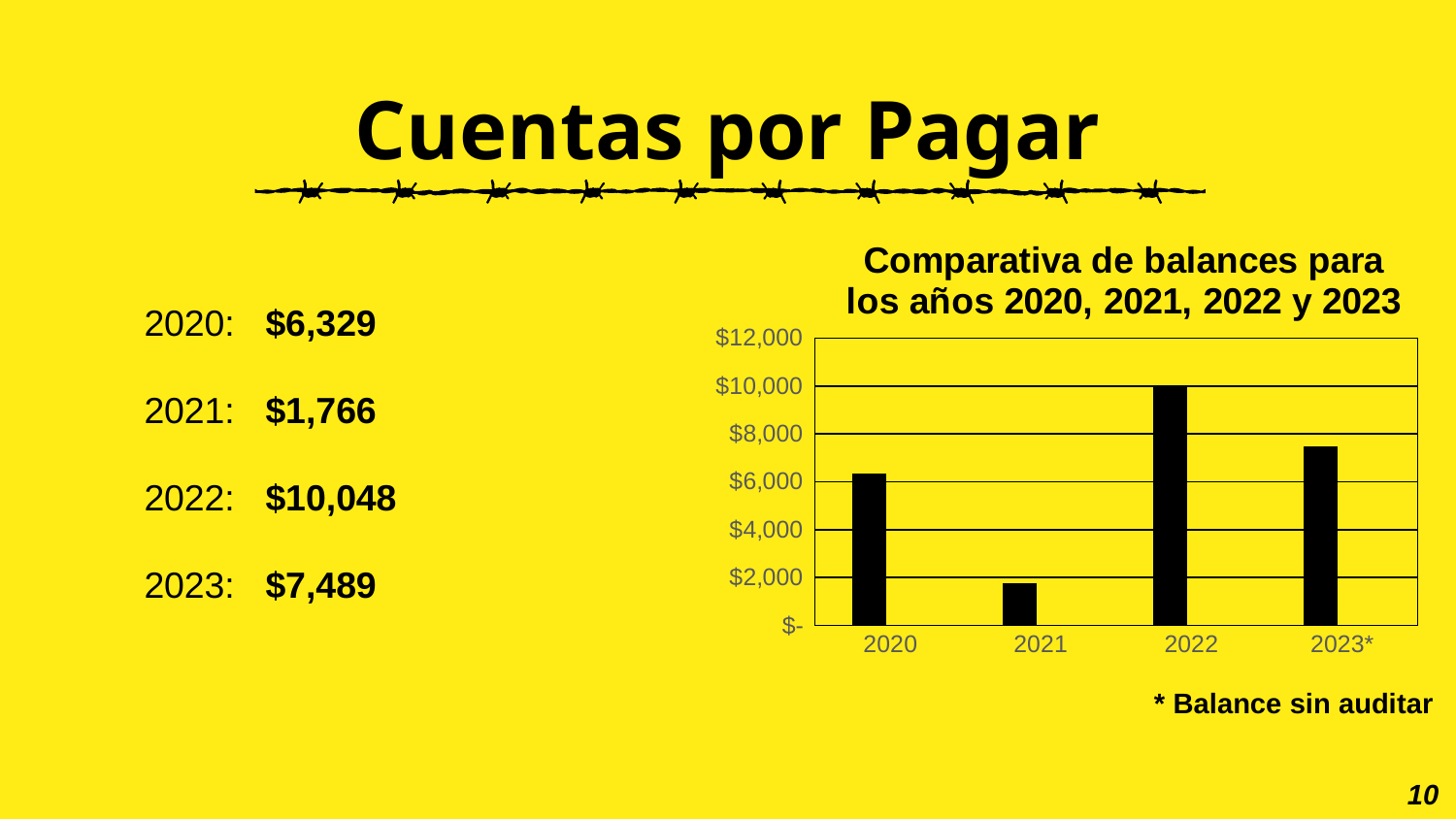
What is the difference between the values for 2022 and 2020? $3,719 Which is larger, the value for 2023 or the value for 2020? 2023 What is the title of the chart? Comparativa de balances para los años 2020, 2021, 2022 y 2023 Which year has the lowest value in the chart? 2021 How many years are shown on the x axis of the chart? 4 What is the value for 2020 in the chart? $6,329 What is the value for 2022 in the chart? $10,048 What is the value for 2021 in the chart? $1,766 What is the value for 2023 in the chart? $7,489 Is the value for 2022 greater or less than $8,000? greater Which year has the highest value in the chart? 2022 What kind of chart is shown on the slide? bar chart